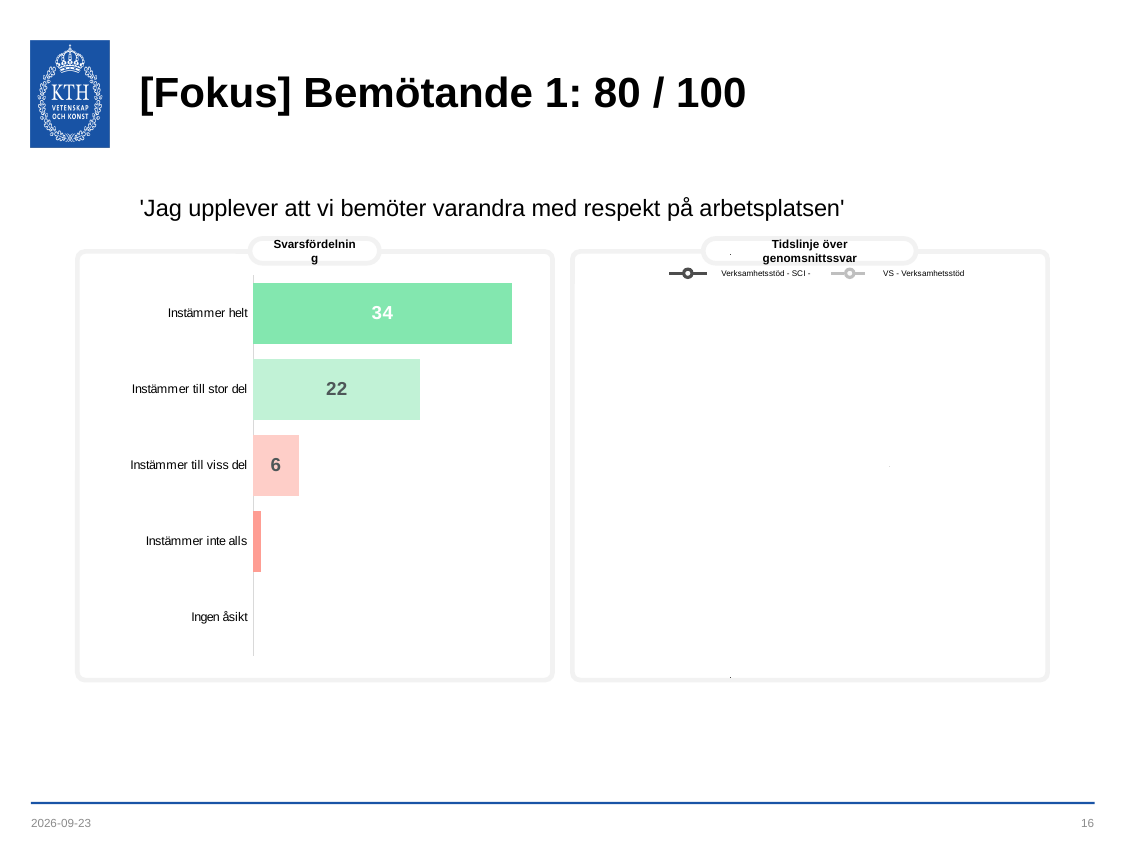
In the Svarsfördelning chart, what is the value for Instämmer helt? 34 How many categories are listed on the Svarsfördelning chart? 5 In the Svarsfördelning chart, which is larger: Instämmer till stor del or Instämmer till viss del? Instämmer till stor del How many series does the legend of the Tidslinje över genomsnittssvar chart list? 2 In the Svarsfördelning chart, what is the difference between Instämmer helt and Instämmer till stor del? 12 In the Svarsfördelning chart, what is the value for Instämmer till viss del? 6 In the Svarsfördelning chart, which is larger: Instämmer helt or Instämmer till viss del? Instämmer helt What kind of chart is the Svarsfördelning chart? bar chart In the Svarsfördelning chart, which category has the highest value? Instämmer helt In the Svarsfördelning chart, what is the difference between Instämmer till stor del and Instämmer till viss del? 16 In the Svarsfördelning chart, what is the value for Instämmer till stor del? 22 What is the title of the chart on the left side of the slide? Svarsfördelning